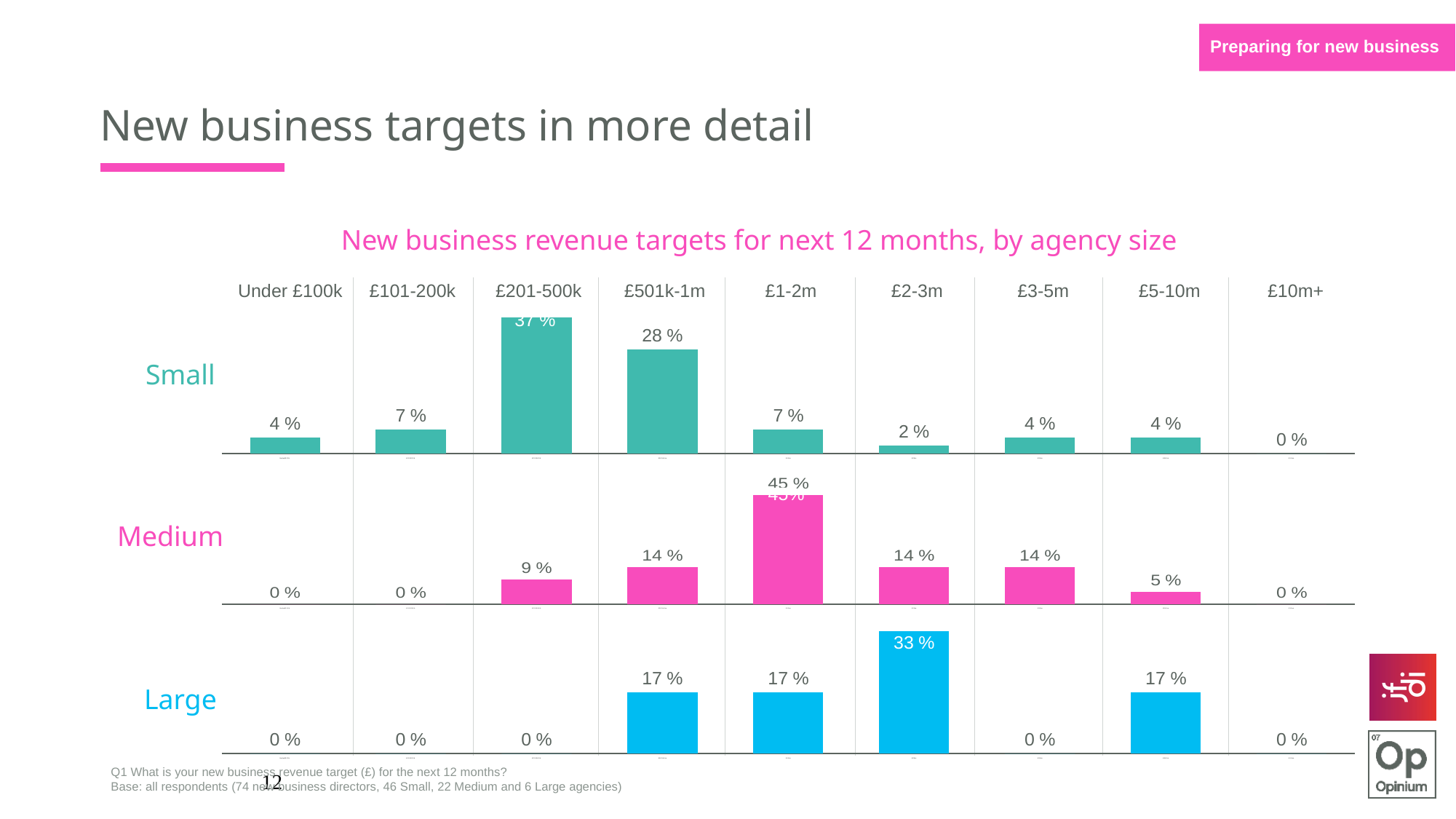
In the Small agencies chart, what is the value for £2-3m? 2 % In the Large agencies chart, what is the value for £2-3m? 33 % In the Medium agencies chart, which is larger, the value for £201-500k or the value for £501k-1m? £501k-1m In the Small agencies chart, what is the difference between the values for £201-500k and £501k-1m? 9 % What colour are the bars in the Large agencies chart? Blue In the Small agencies chart, what is the value for £201-500k? 37 % What kind of chart is used to show the new business revenue targets by agency size? Bar chart In the Medium agencies chart, what is the value for £1-2m? 45 % In the Small agencies chart, which revenue target band has the highest value? £201-500k In the Medium agencies chart, which revenue target band has the highest value? £1-2m How many revenue target bands are shown along the x axis of each chart? 9 In the Large agencies chart, what is the difference between the values for £2-3m and £5-10m? 16 %